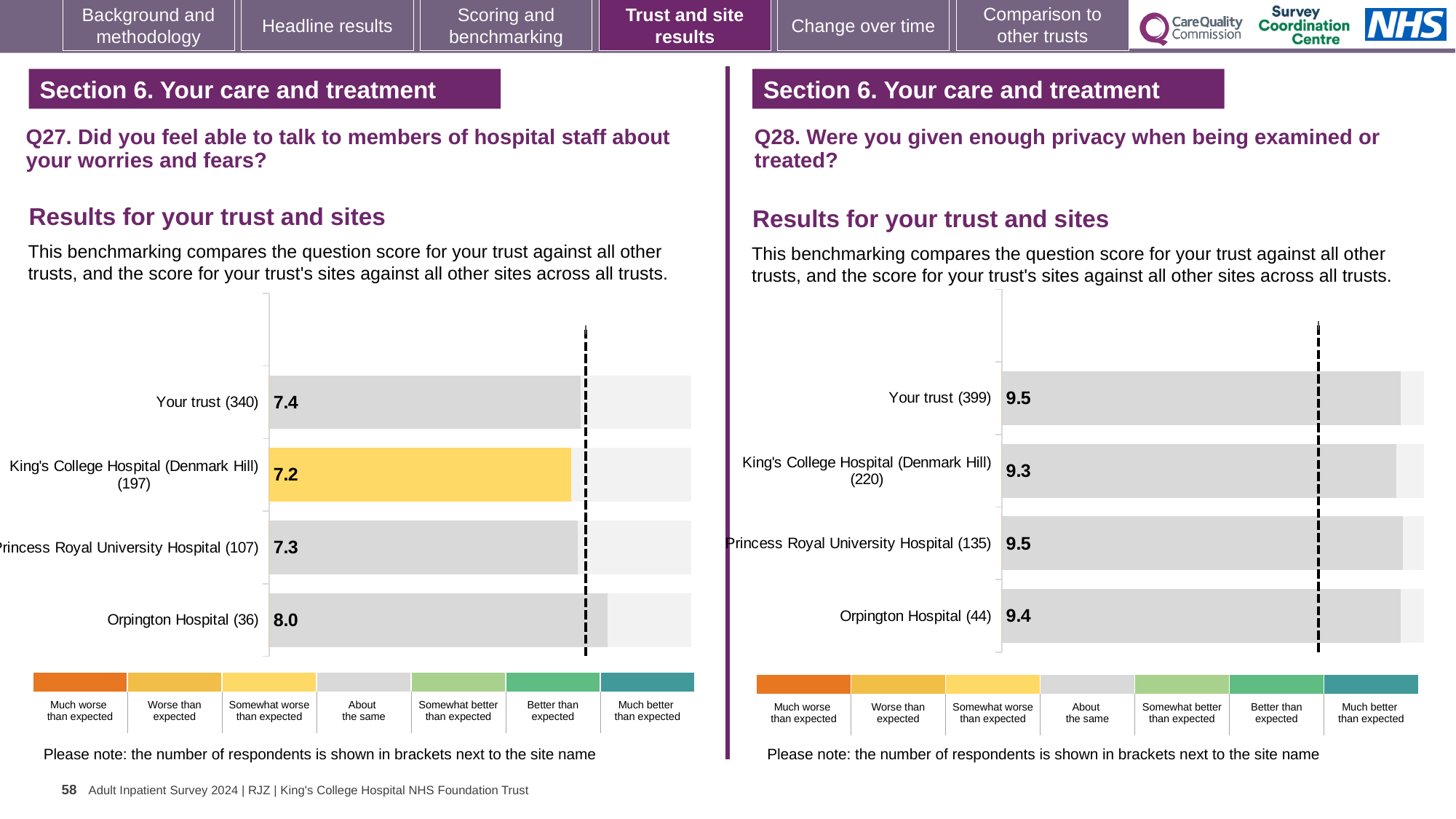
In the Q28 chart on the right, which site has the lowest score? King's College Hospital (Denmark Hill) How many bars are plotted in the Q28 chart on the right? 4 In the Q27 chart on the left, what is the difference between the scores for Orpington Hospital and King's College Hospital (Denmark Hill)? 0.8 In the Q27 chart on the left, which benchmark category does the yellow colour of the King's College Hospital (Denmark Hill) bar indicate? Somewhat worse than expected In the Q27 chart on the left, what is the score for King's College Hospital (Denmark Hill)? 7.2 In the Q27 chart on the left, which site has the highest score? Orpington Hospital In the Q27 chart on the left, which site has the lowest score? King's College Hospital (Denmark Hill) In the Q28 chart on the right, what is the score for Your trust? 9.5 In the Q28 chart on the right, what is the difference between the scores for Your trust and King's College Hospital (Denmark Hill)? 0.2 In the Q27 chart on the left, which has the higher score: Princess Royal University Hospital or Your trust? Your trust In the Q27 chart on the left, what is the score for Orpington Hospital? 8.0 In the Q28 chart on the right, what is the score for Orpington Hospital? 9.4